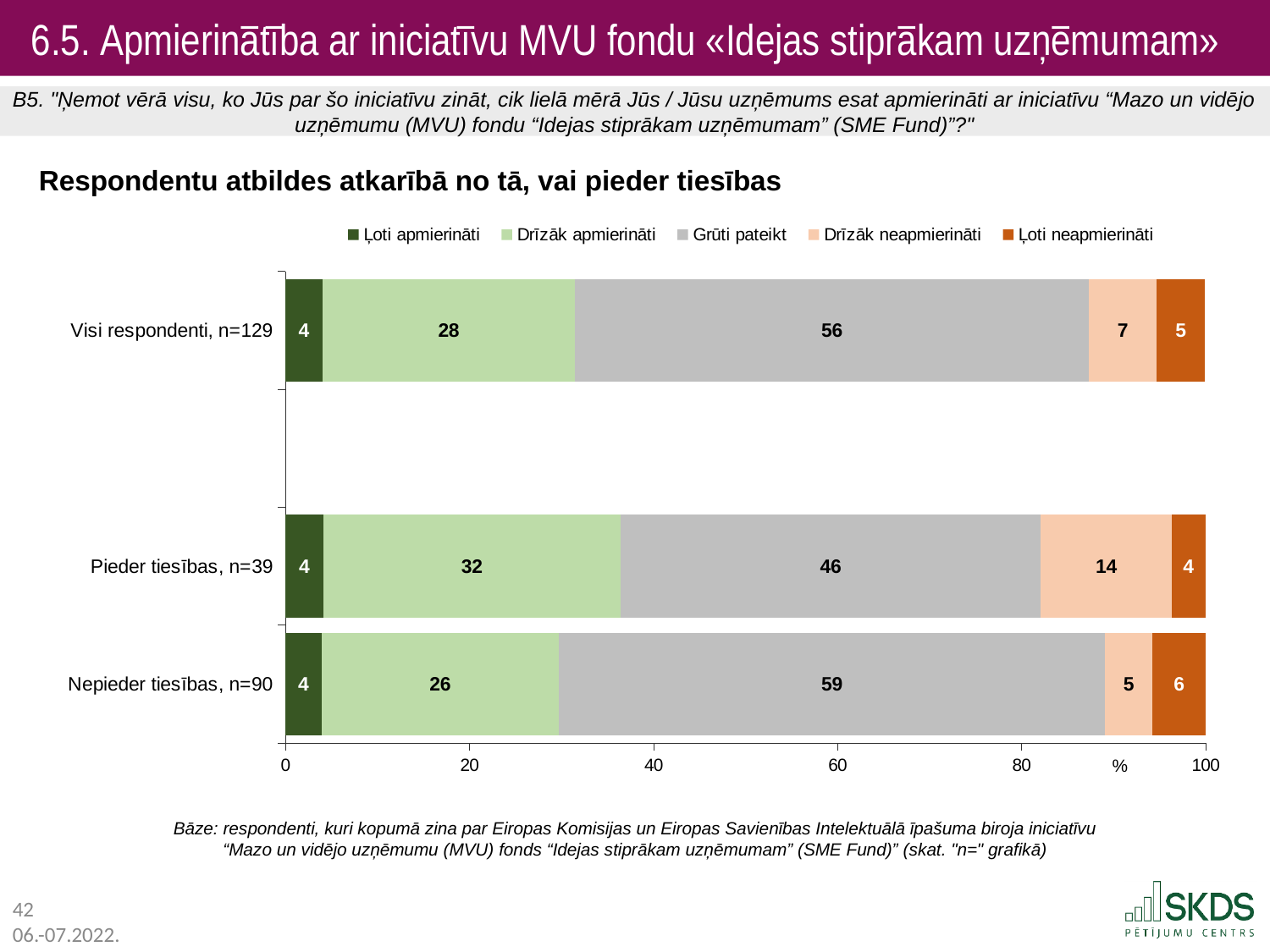
How many series does the legend list? 5 What is the total of the stacked bar for "Pieder tiesības, n=39"? 100 What is the value for "Drīzāk neapmierināti" for "Nepieder tiesības, n=90"? 5 Which category has the highest value for "Grūti pateikt"? Nepieder tiesības, n=90 What kind of chart is shown on the slide? Stacked bar chart How many categories are shown on the chart? 3 Which category has the lowest value for "Drīzāk apmierināti"? Nepieder tiesības, n=90 Which is larger: the "Grūti pateikt" value for "Pieder tiesības, n=39" or for "Visi respondenti, n=129"? Visi respondenti, n=129 What is the difference between the "Drīzāk neapmierināti" values for "Pieder tiesības, n=39" and "Nepieder tiesības, n=90"? 9 What is the value for "Grūti pateikt" for "Visi respondenti, n=129"? 56 What is the value for "Ļoti neapmierināti" for "Pieder tiesības, n=39"? 4 What is the value for "Drīzāk apmierināti" for "Pieder tiesības, n=39"? 32